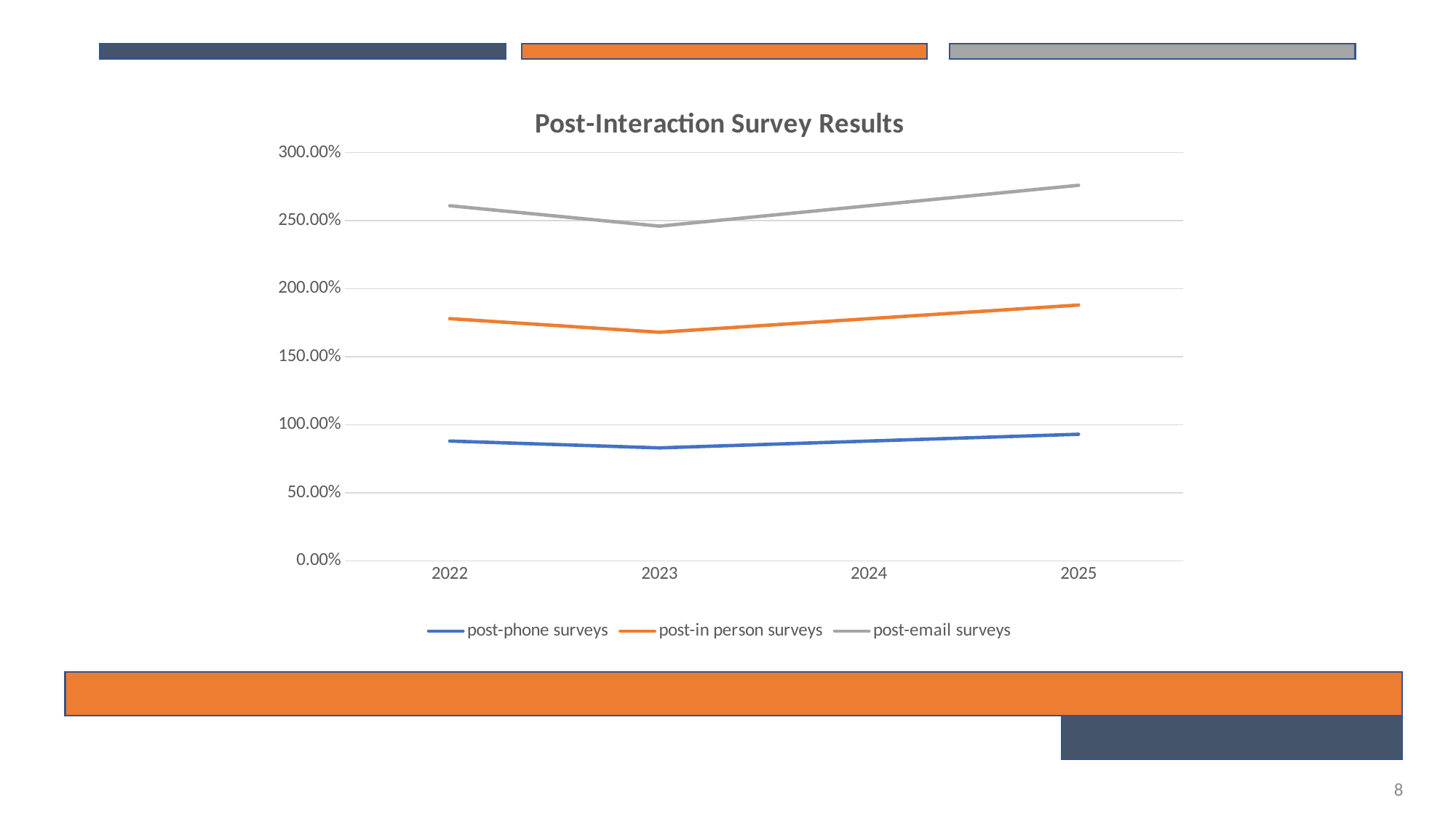
Is the value for post-phone surveys in 2023 greater or less than 100.00%? less What is the title of the chart? Post-Interaction Survey Results Is the value for post-in person surveys in 2025 greater or less than 200.00%? less What type of chart is shown on the slide? line chart Do the post-phone surveys values rise or fall from 2023 to 2025? rise How many years are shown on the x axis? 4 In which year is the post-in person surveys value lowest? 2023 In which year is the post-email surveys value highest? 2025 How many series does the legend list? 3